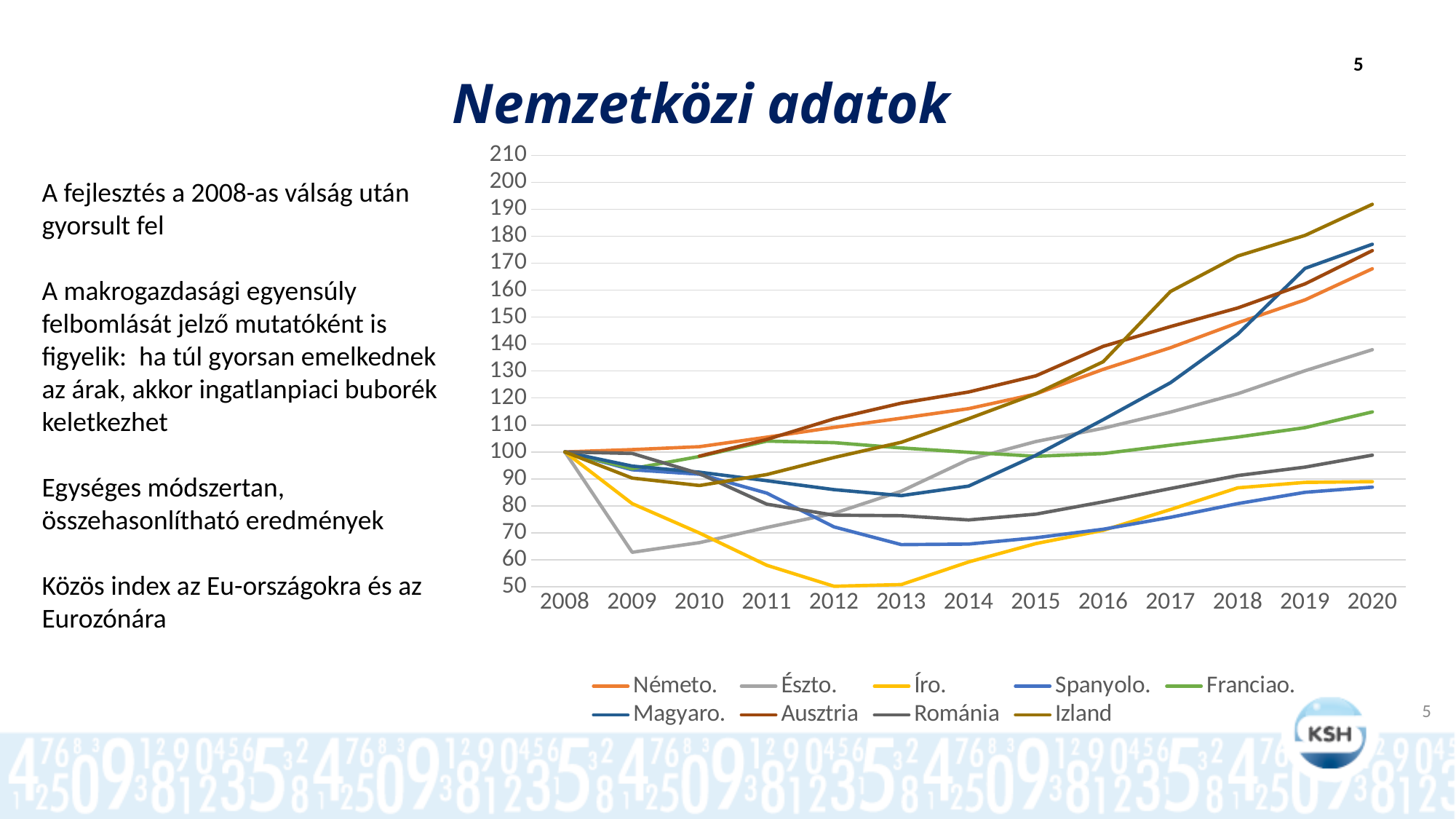
Which is larger in 2020, the value for Észto. or the value for Franciao.? Észto. Is the value for Izland in 2020 greater or less than 180? greater Is the value for Észto. in 2009 greater or less than 70? less How many years are shown on the x axis of the chart? 13 What kind of chart is shown on the slide? line chart Is the value for Ausztria in 2016 greater or less than 130? greater How many series does the chart legend list? 9 What is the title of the chart slide? Nemzetközi adatok Does the value for Izland rise or fall from 2010 to 2020? rise Which series has the lowest value in 2013? Íro. What is the value for Németo. in 2008? 100 Which series has the highest value in 2020? Izland